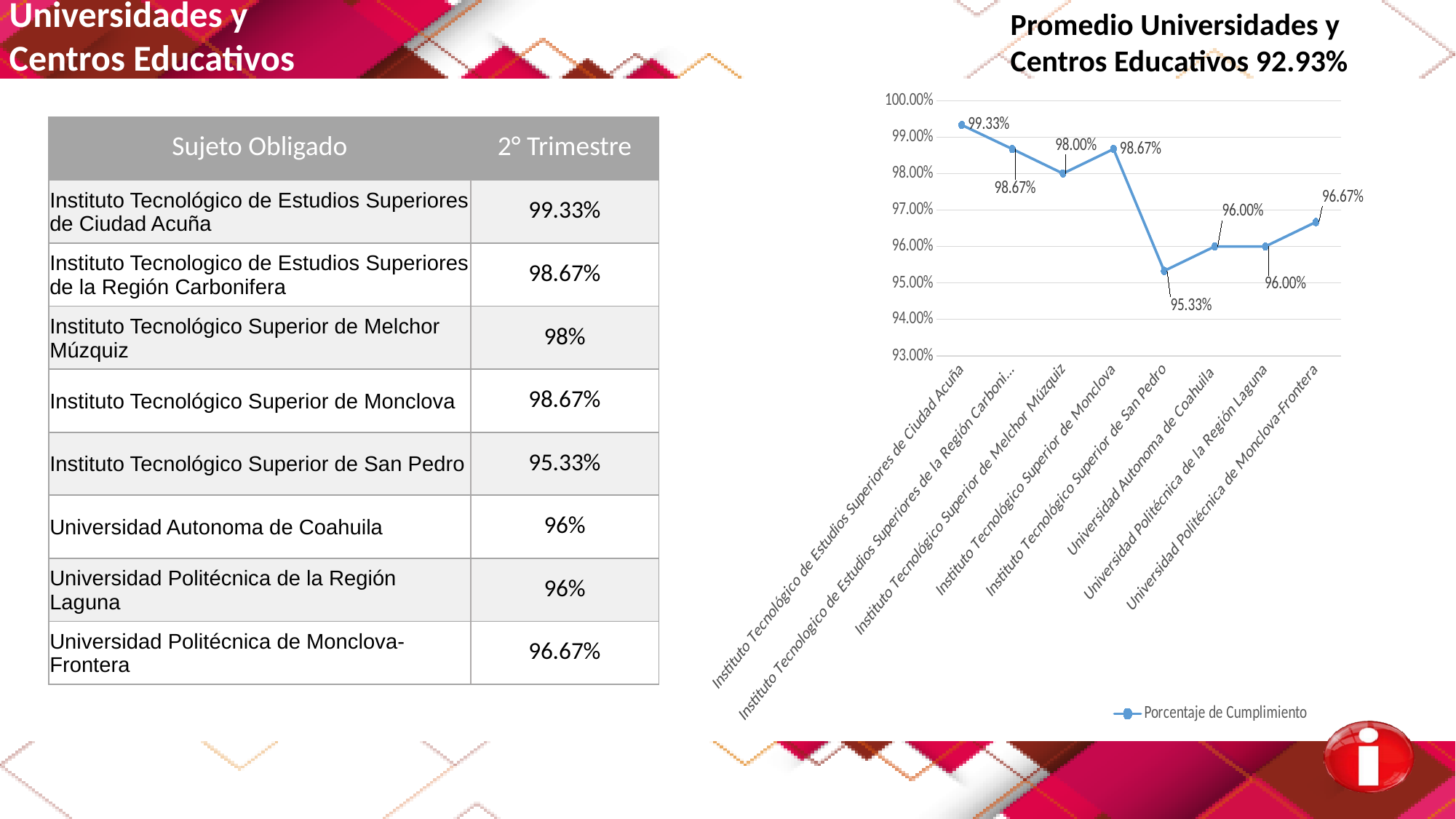
How many series does the legend of the chart list? 1 What is the value for Instituto Tecnológico de Estudios Superiores de Ciudad Acuña in the line chart? 99.33% Which has a larger value in the line chart: Instituto Tecnológico Superior de Melchor Múzquiz or Instituto Tecnológico Superior de Monclova? Instituto Tecnológico Superior de Monclova Which category has the highest value in the line chart? Instituto Tecnológico de Estudios Superiores de Ciudad Acuña What is the value for Universidad Politécnica de Monclova-Frontera in the line chart? 96.67% What is the value for Instituto Tecnológico Superior de San Pedro in the line chart? 95.33% Which category has the lowest value in the line chart? Instituto Tecnológico Superior de San Pedro How many categories are plotted on the x axis of the line chart? 8 What is the difference between the highest value (Ciudad Acuña) and the lowest value (San Pedro) in the line chart? 4.00% What is the value for Instituto Tecnológico Superior de Melchor Múzquiz in the line chart? 98.00% Is the value for Instituto Tecnológico Superior de San Pedro greater or less than 96.00%? less What type of chart is shown on the slide? line chart